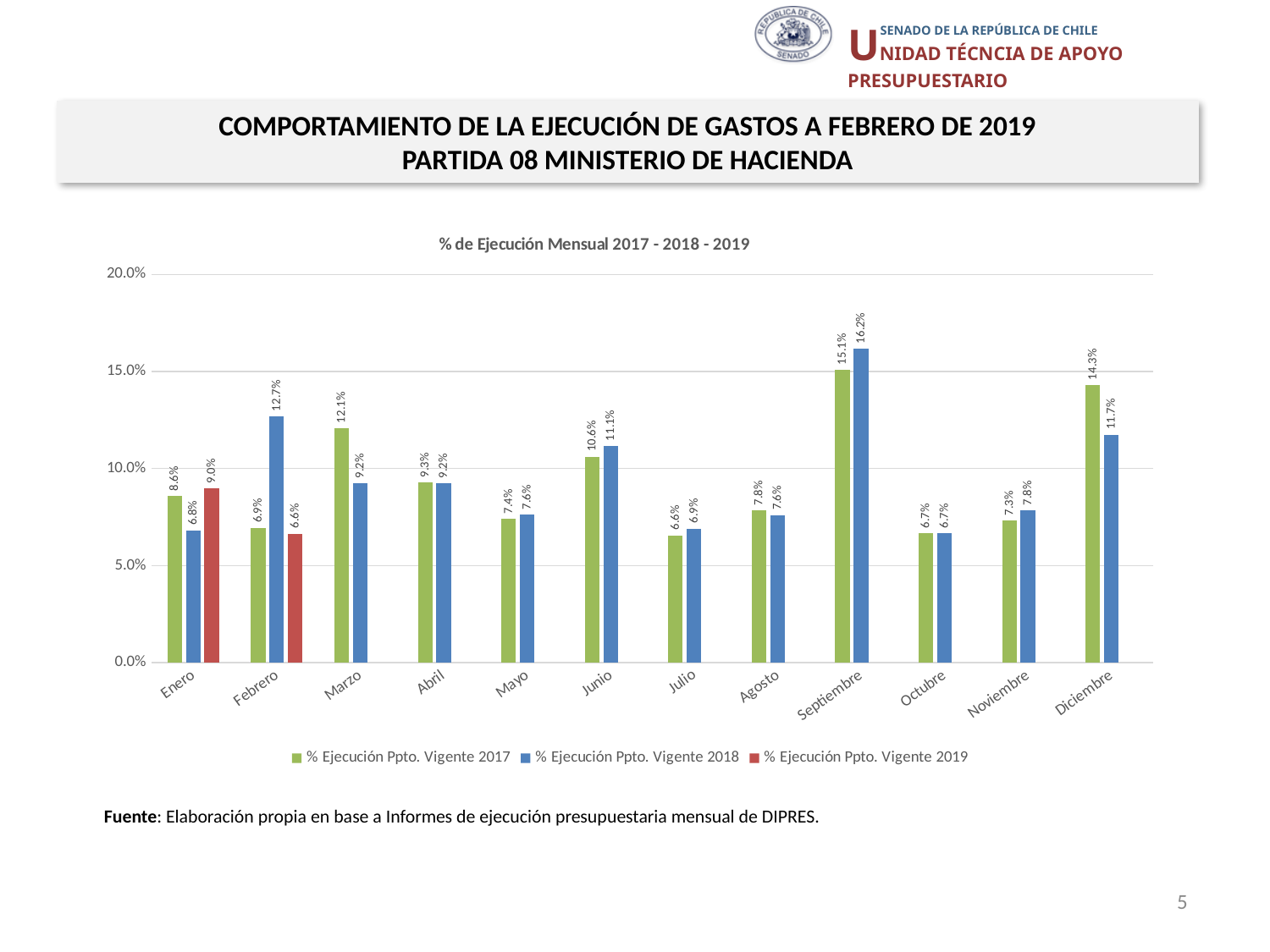
How many series does the legend list? 3 For Marzo, which series has the larger value, 2017 or 2018? 2017 What is the value for Diciembre in the % Ejecución Ppto. Vigente 2017 series? 14.3% Is the value for Junio in the 2018 series greater or less than 10.0%? greater Which month has the lowest value in the % Ejecución Ppto. Vigente 2017 series? Julio What is the difference between the 2018 and 2017 values for Febrero? 5.8% How many months are shown on the x axis? 12 What is the value for Septiembre in the % Ejecución Ppto. Vigente 2018 series? 16.2% What is the title of the chart? % de Ejecución Mensual 2017 - 2018 - 2019 What kind of chart is shown on the slide? Bar chart Which month has the highest value in the % Ejecución Ppto. Vigente 2018 series? Septiembre What is the value for Enero in the % Ejecución Ppto. Vigente 2019 series? 9.0%